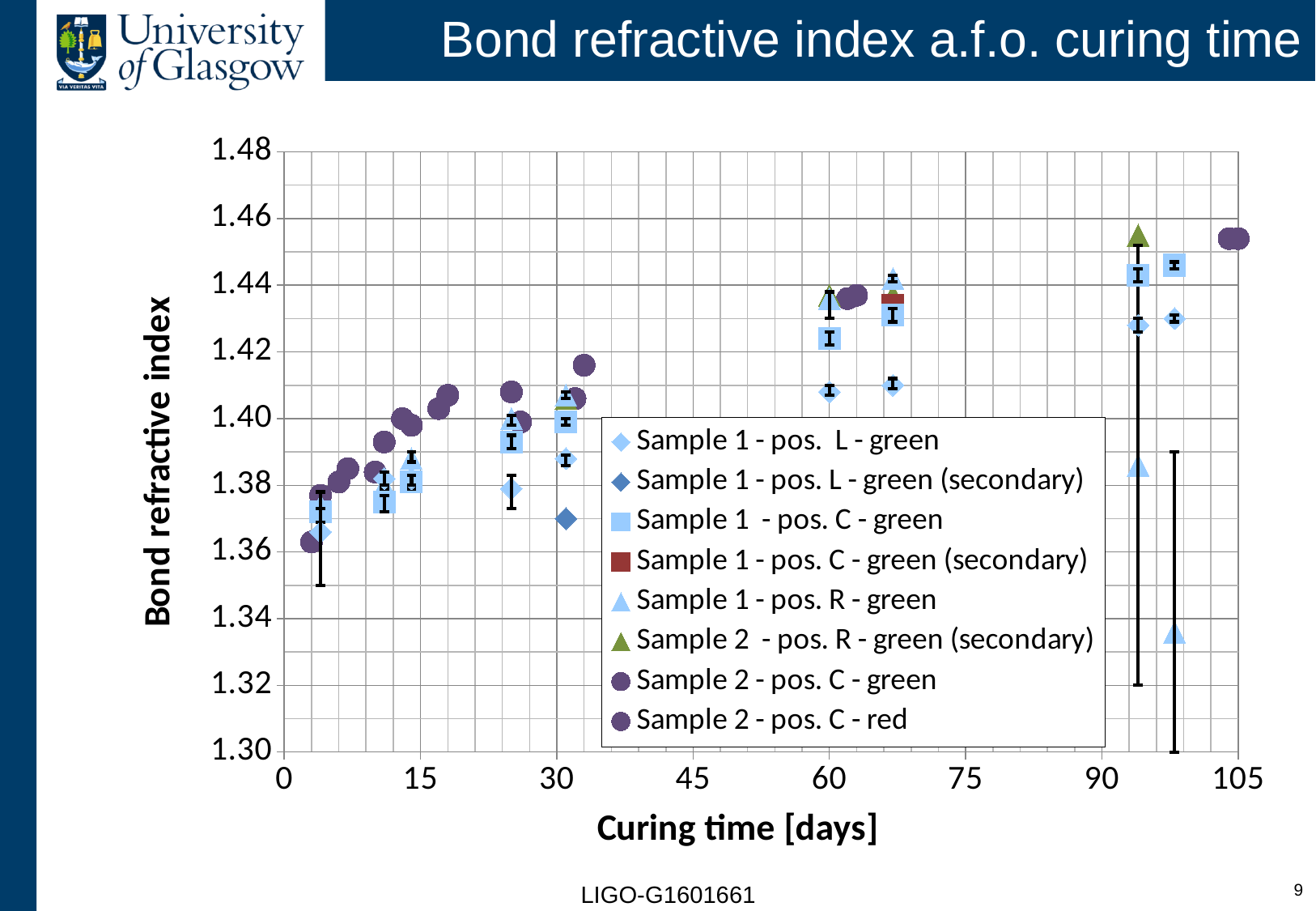
Is the value for Sample 1 - pos. C - green at about 60 days greater or less than 1.40? greater Is the value for Sample 2 - pos. R - green (secondary) at about 94 days greater or less than 1.44? greater What is the label of the x axis? Curing time [days] Is the value for Sample 1 - pos. L - green (secondary) at about 31 days greater or less than 1.38? less Do the bond refractive index values generally rise or fall as curing time increases? rise What is the title of the chart? Bond refractive index a.f.o. curing time What kind of chart is shown on the slide? scatter chart How many series does the legend list? 8